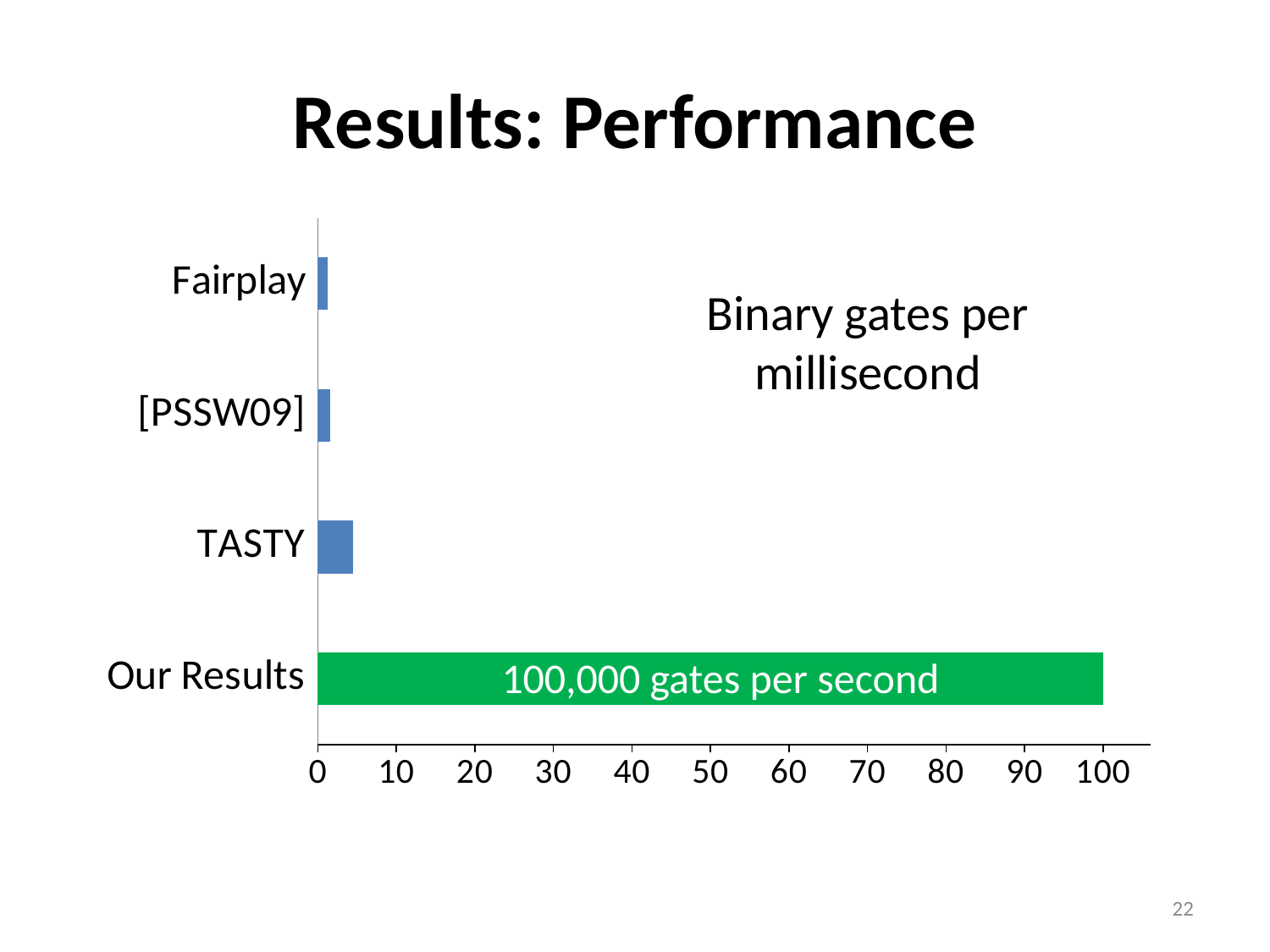
How many categories are plotted in the chart? 4 What text is printed on the Our Results bar? 100,000 gates per second What is the title of the slide containing the chart? Results: Performance Is the value for TASTY greater or less than 10? less Is the value for Our Results greater or less than 90? greater Is the value for Fairplay greater or less than 10? less What kind of chart is shown on the slide? bar chart Which category has the highest value in the chart? Our Results Which has a larger value, Our Results or TASTY? Our Results What value does the Our Results bar reach on the axis? 100 Which has a larger value, TASTY or Fairplay? TASTY